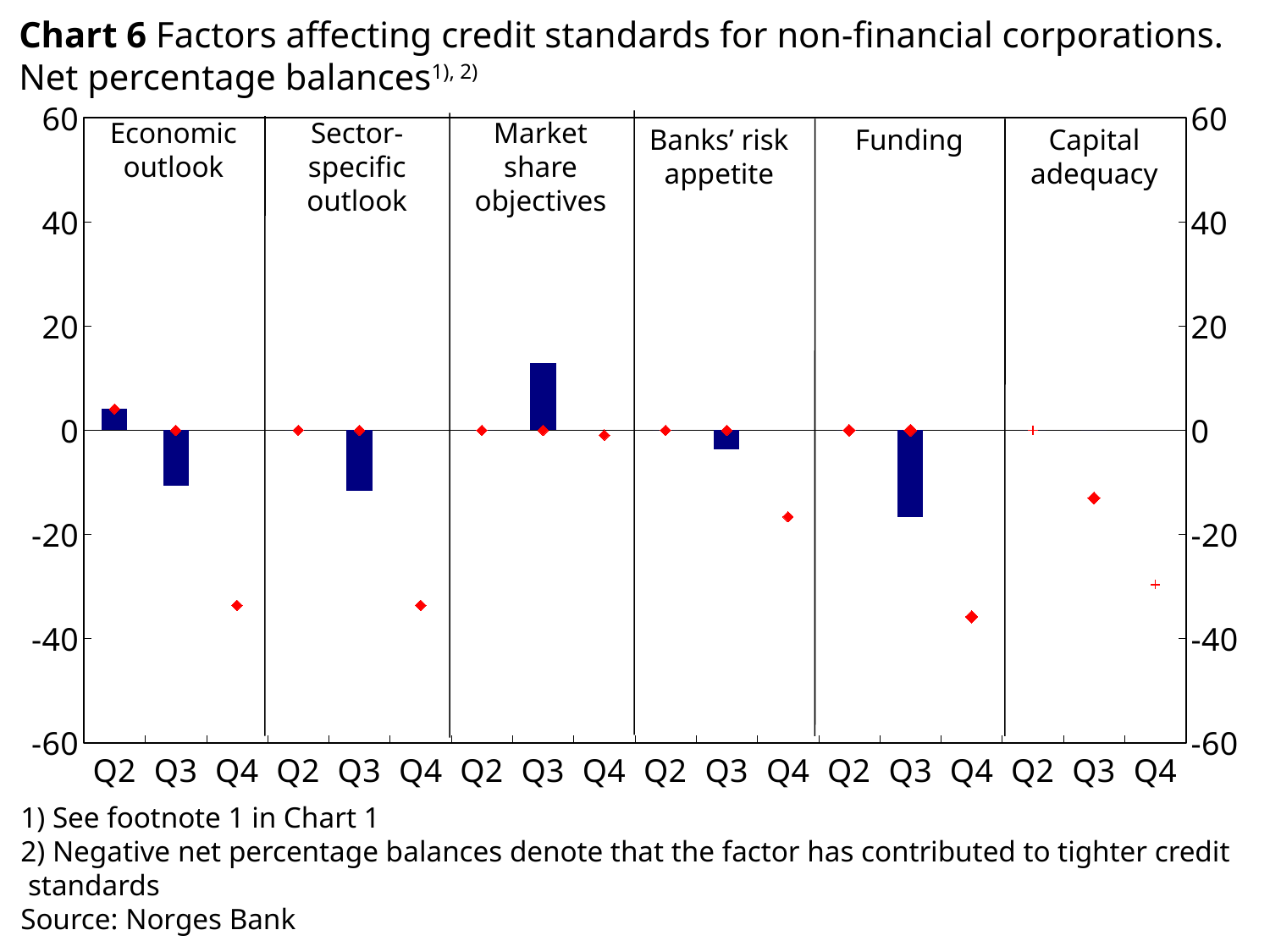
Is the Q4 value for Capital adequacy greater or less than -20? less What kind of chart is shown on the slide? bar chart Which is larger, the Q3 value for Economic outlook or the Q3 value for Market share objectives? Market share objectives Is the Q4 value for Funding greater or less than -20? less Is the Q3 value for Market share objectives greater or less than 20? less Which factor has the highest Q3 value? Market share objectives How many quarters are shown for each factor? 3 How many factors (panels) are shown in the chart? 6 What is the source given for the chart? Norges Bank Which factor has the lowest Q3 value? Funding Do the values for Funding rise or fall from Q2 to Q4? fall